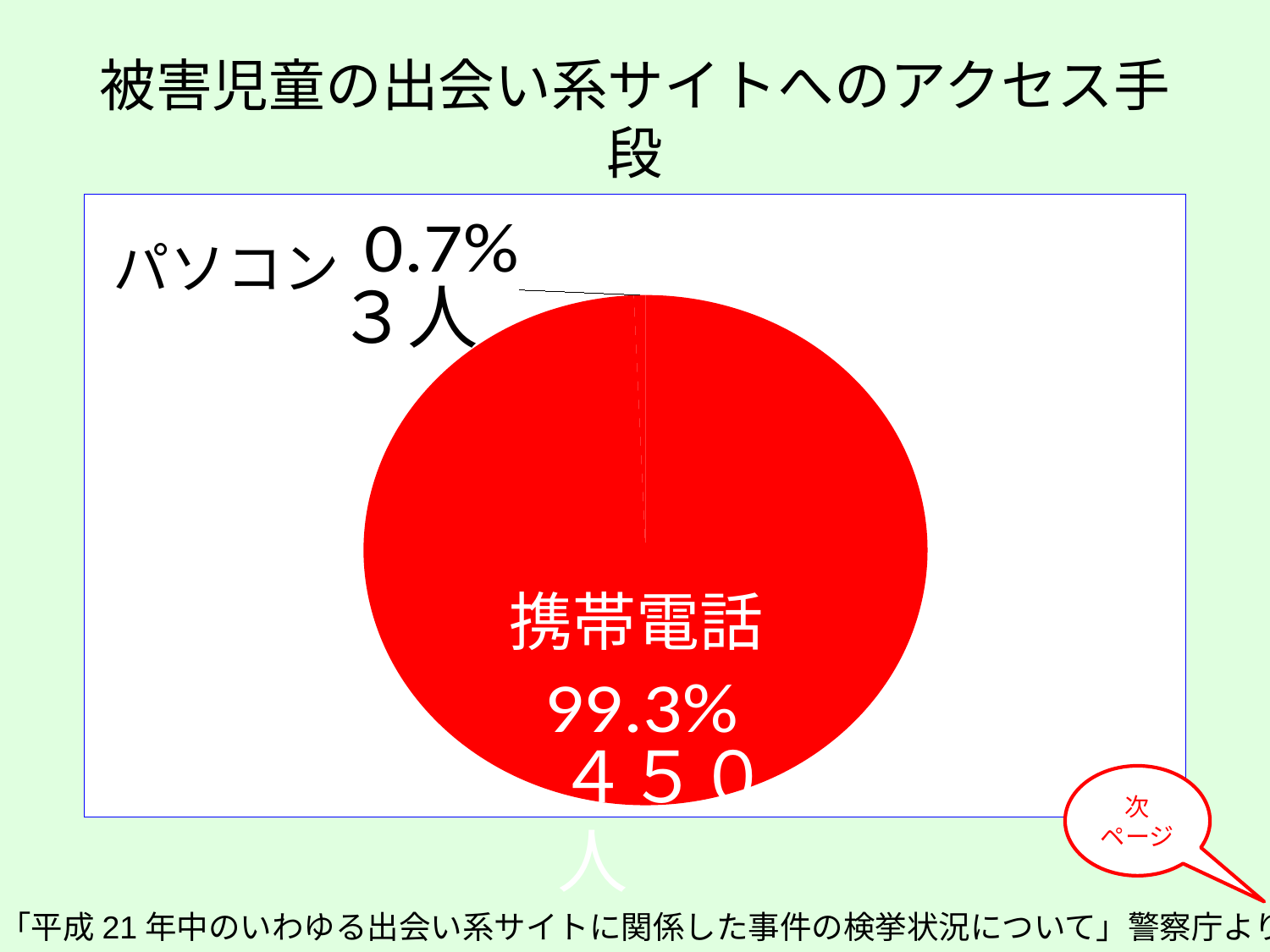
What is the difference in the number of people between 携帯電話 and パソコン? 447人 What percentage share does 携帯電話 have in the pie chart? 99.3% Which is larger, the number of people for 携帯電話 or for パソコン? 携帯電話 How many people are shown for パソコン? 3人 What colour is the 携帯電話 slice of the pie? red Which category has the smallest slice of the pie? パソコン How many people are shown for 携帯電話? 450人 How many slices does the pie chart have? 2 What percentage share does パソコン have in the pie chart? 0.7% What kind of chart is shown on the slide? pie chart Which category has the largest slice of the pie? 携帯電話 What is the title of the chart on the slide? 被害児童の出会い系サイトへのアクセス手段